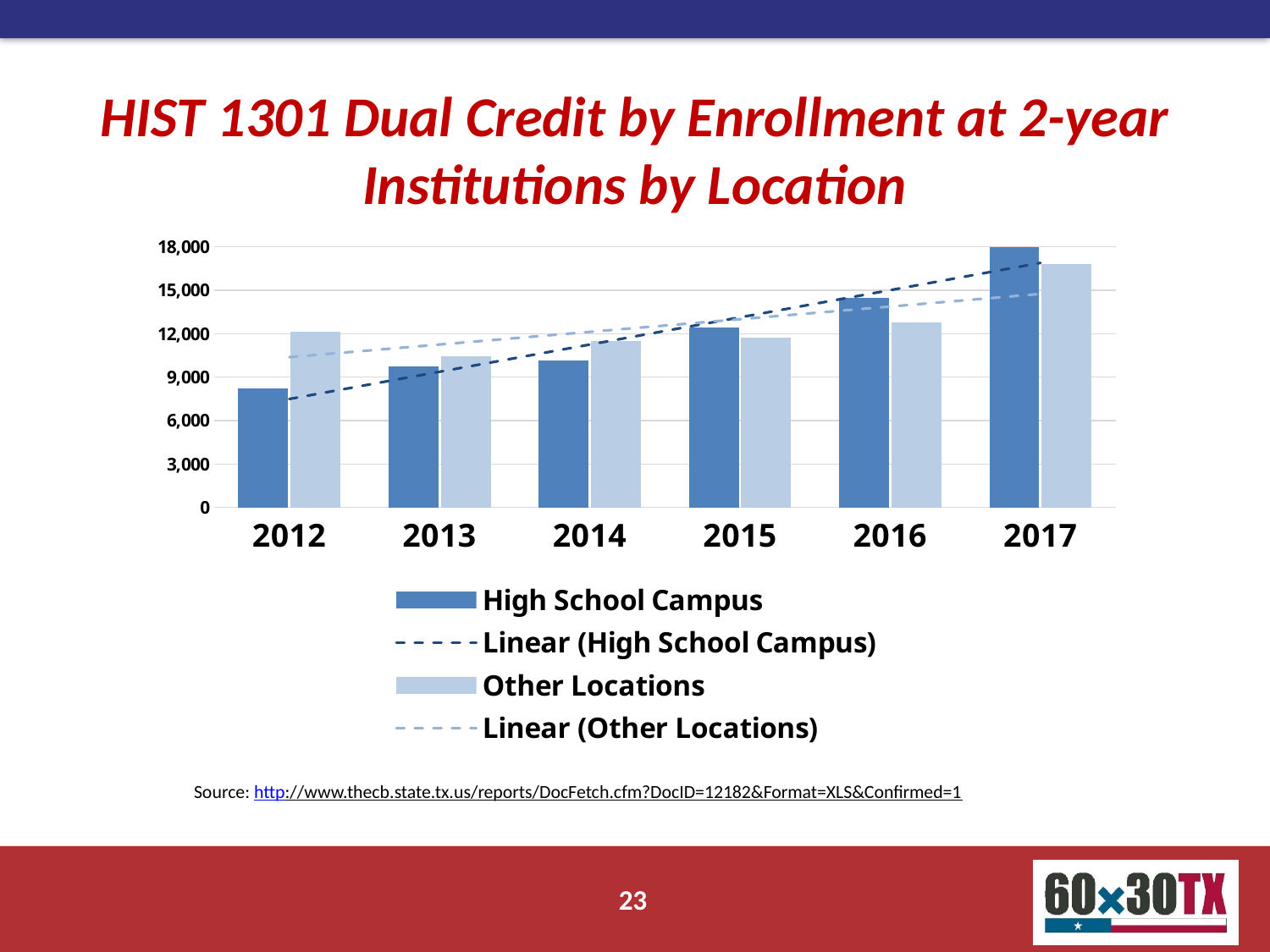
How many entries does the chart's legend list? 4 In which year is the High School Campus enrollment lowest? 2012 Does the High School Campus enrollment rise or fall from 2012 to 2017? Rises Is the High School Campus value for 2012 greater or less than 9,000? less In 2017, which is larger: High School Campus or Other Locations enrollment? High School Campus In which year is the High School Campus enrollment highest? 2017 In which year is the Other Locations enrollment highest? 2017 How many years are shown on the x axis of the chart? 6 Is the High School Campus value for 2016 greater or less than 15,000? less What kind of chart is shown on the slide? Bar chart Is the Other Locations value for 2017 greater or less than 15,000? greater In 2012, which is larger: High School Campus or Other Locations enrollment? Other Locations